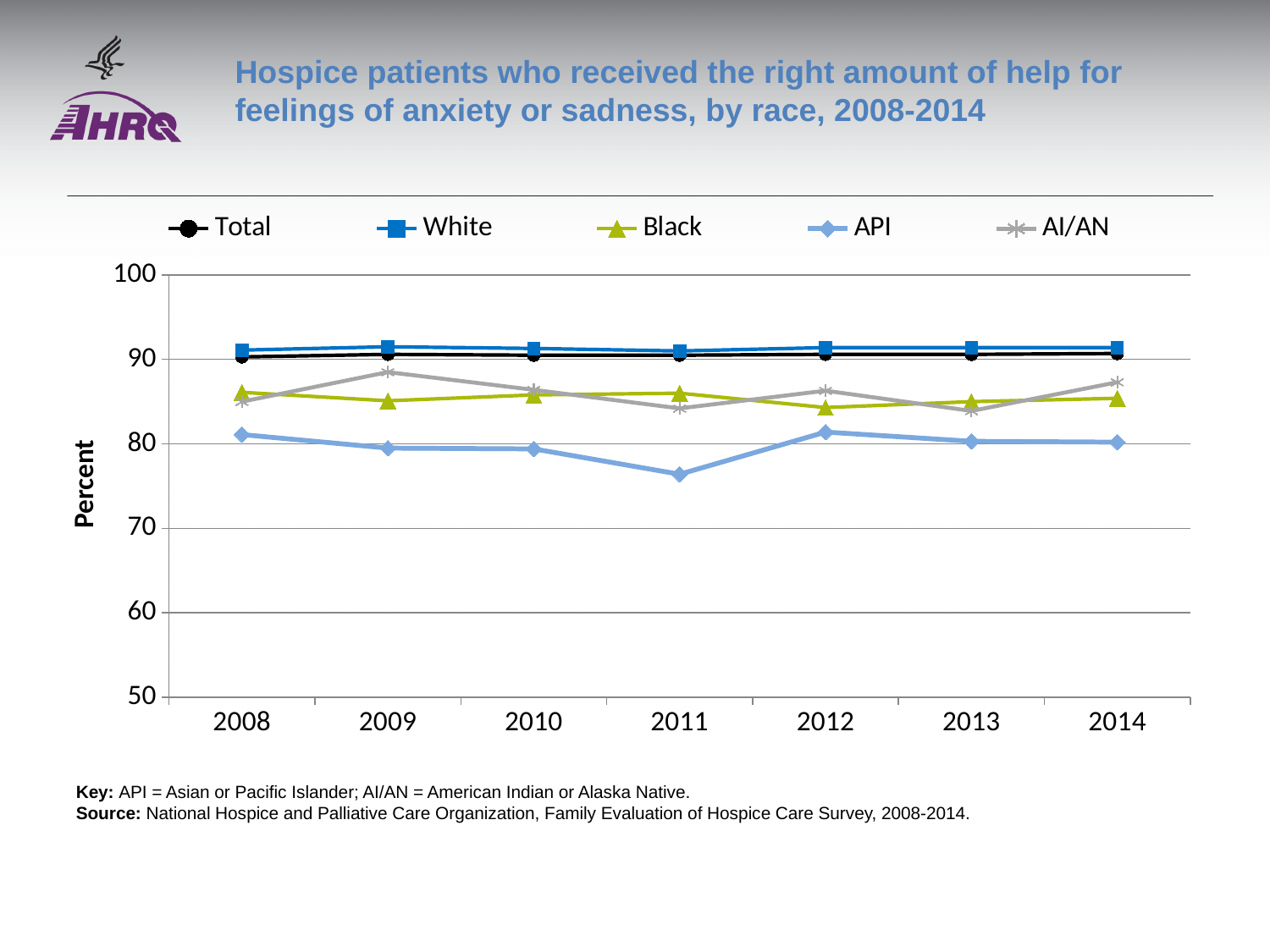
Which is larger in 2009, the value for AI/AN or the value for API? AI/AN How many years are shown along the x axis? 7 Does the API series rise or fall from 2008 to 2011? fall How many series does the legend list? 5 What kind of chart is shown on the slide? line chart In which year does the API series reach its lowest value? 2011 Is the value for API in 2011 greater or less than 80? less Which is larger in 2011, the value for White or the value for API? White Which series has the lowest value in 2011? API What is the label on the y axis? Percent Is the value for Black in 2012 greater or less than 90? less Is the value for White in 2014 greater or less than 80? greater